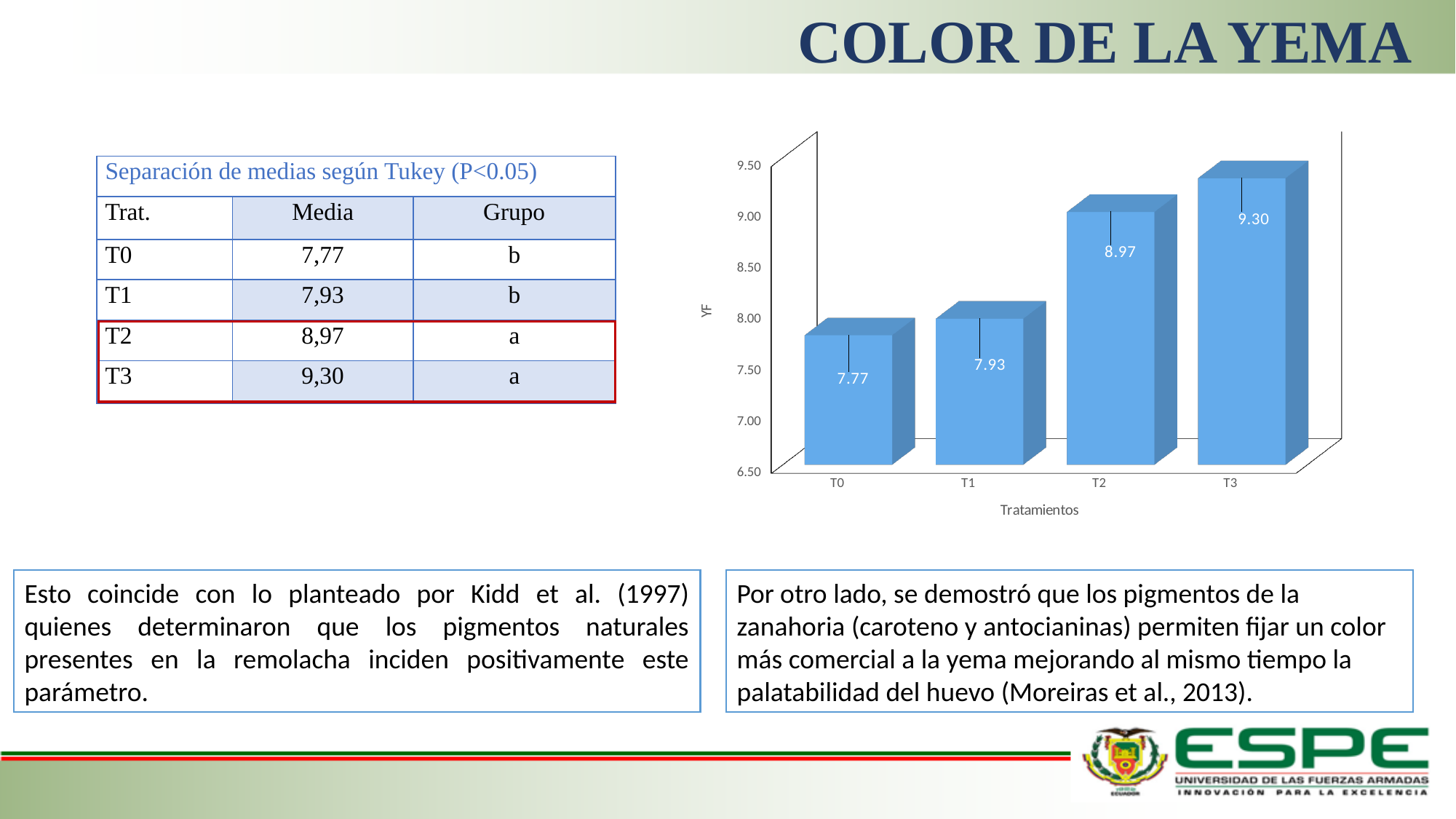
How many treatments are shown on the x axis of the chart? 4 Which treatment has the highest value in the chart? T3 Which is larger, the value for T1 or the value for T2? T2 What is the value for T3 in the chart? 9.30 What kind of chart is shown on the slide? bar chart What is the value for T0 in the chart? 7.77 What is the value for T2 in the chart? 8.97 Which treatment has the lowest value in the chart? T0 Is the value for T1 greater or less than 8.00? less Do the values rise or fall from T0 to T3 along the x axis? rise What is the difference between the values for T3 and T0? 1.53 What is the difference between the values for T2 and T1? 1.04